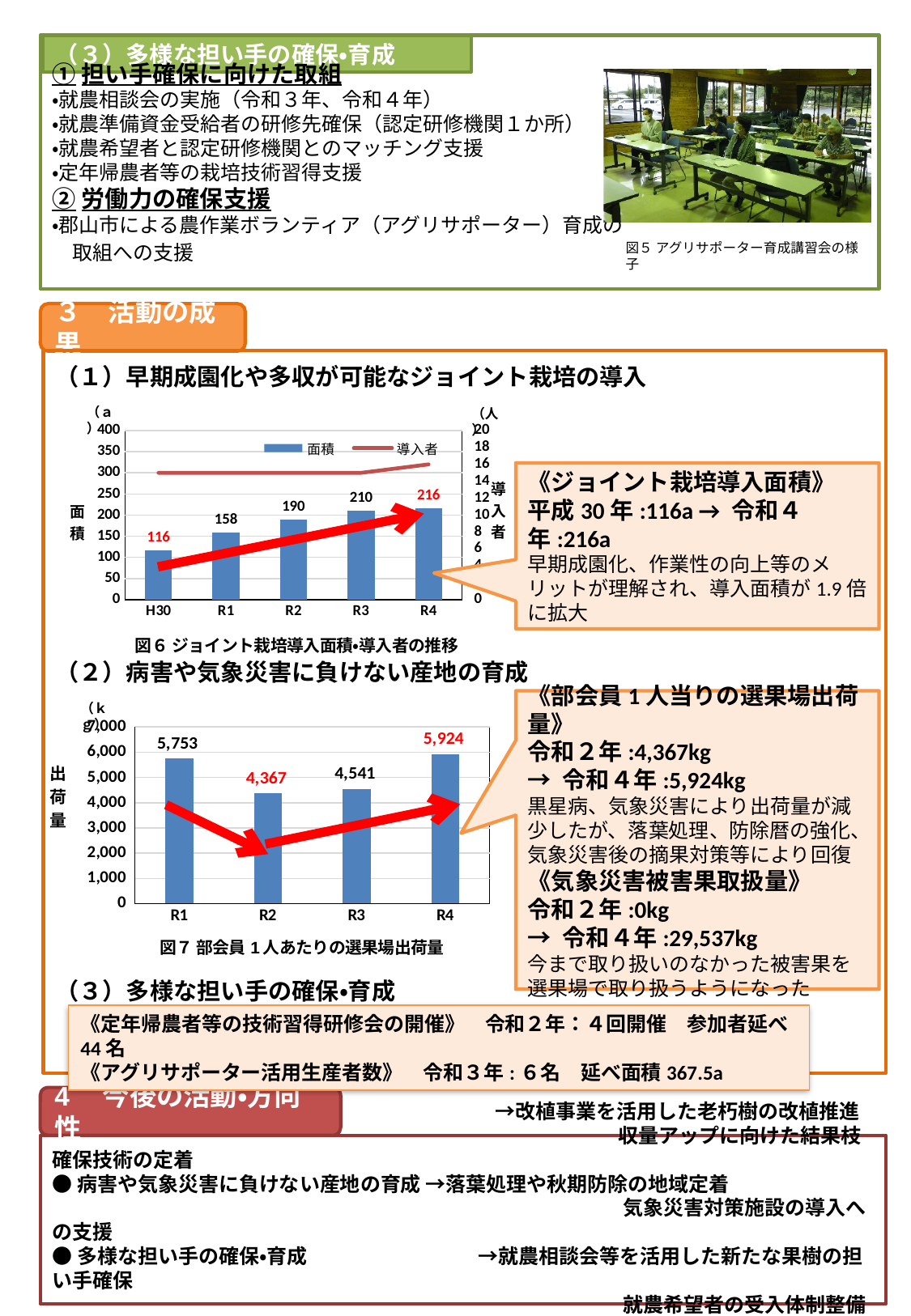
In the chart 図6 ジョイント栽培導入面積・導入者の推移, which year has the lowest 面積 value? H30 In the chart 図7 部会員1人あたりの選果場出荷量, what is the difference between the values for R4 and R2? 1,557 In the chart 図7 部会員1人あたりの選果場出荷量, which year has the lowest value? R2 In the chart 図6 ジョイント栽培導入面積・導入者の推移, what is the 面積 value for H30? 116 In the chart 図6 ジョイント栽培導入面積・導入者の推移, how many series does the legend list? 2 In the chart 図6 ジョイント栽培導入面積・導入者の推移, what is the 面積 value for R4? 216 What kind of chart is 図7 部会員1人あたりの選果場出荷量? bar chart In the chart 図7 部会員1人あたりの選果場出荷量, what is the value for R2? 4,367 In the chart 図6 ジョイント栽培導入面積・導入者の推移, what is the difference between the 面積 values for R4 and H30? 100 In the chart 図6 ジョイント栽培導入面積・導入者の推移, does the 面積 value rise or fall from H30 to R4? rise In the chart 図6 ジョイント栽培導入面積・導入者の推移, how many years are shown on the x axis? 5 In the chart 図7 部会員1人あたりの選果場出荷量, which year has the highest value? R4